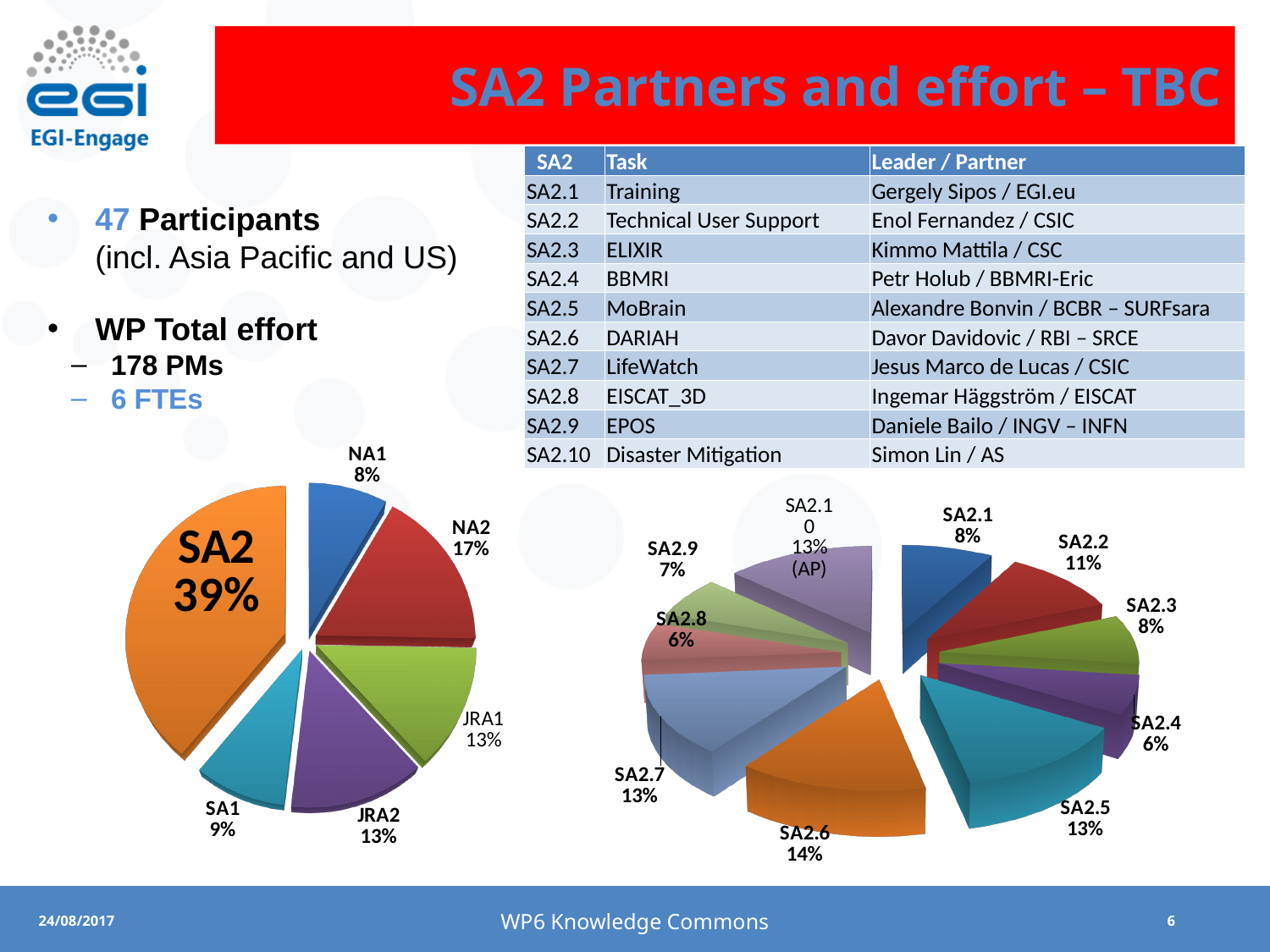
On the left pie chart, which category has the largest slice? SA2 On the right pie chart, how many slices are there? 10 On the right pie chart, which is larger, SA2.5 or SA2.9? SA2.5 What type of chart is shown on the right of the slide? Pie chart On the left pie chart, what is the value for NA2? 17% On the left pie chart, what share does SA2 have? 39% On the right pie chart, what is the value for SA2.2? 11% On the left pie chart, which category has the smallest slice? NA1 On the right pie chart, what is the value for SA2.6? 14% On the left pie chart, how many slices are there? 6 On the left pie chart, what is the difference between the SA2 and NA2 shares? 22% On the right pie chart, which task has the largest share? SA2.6